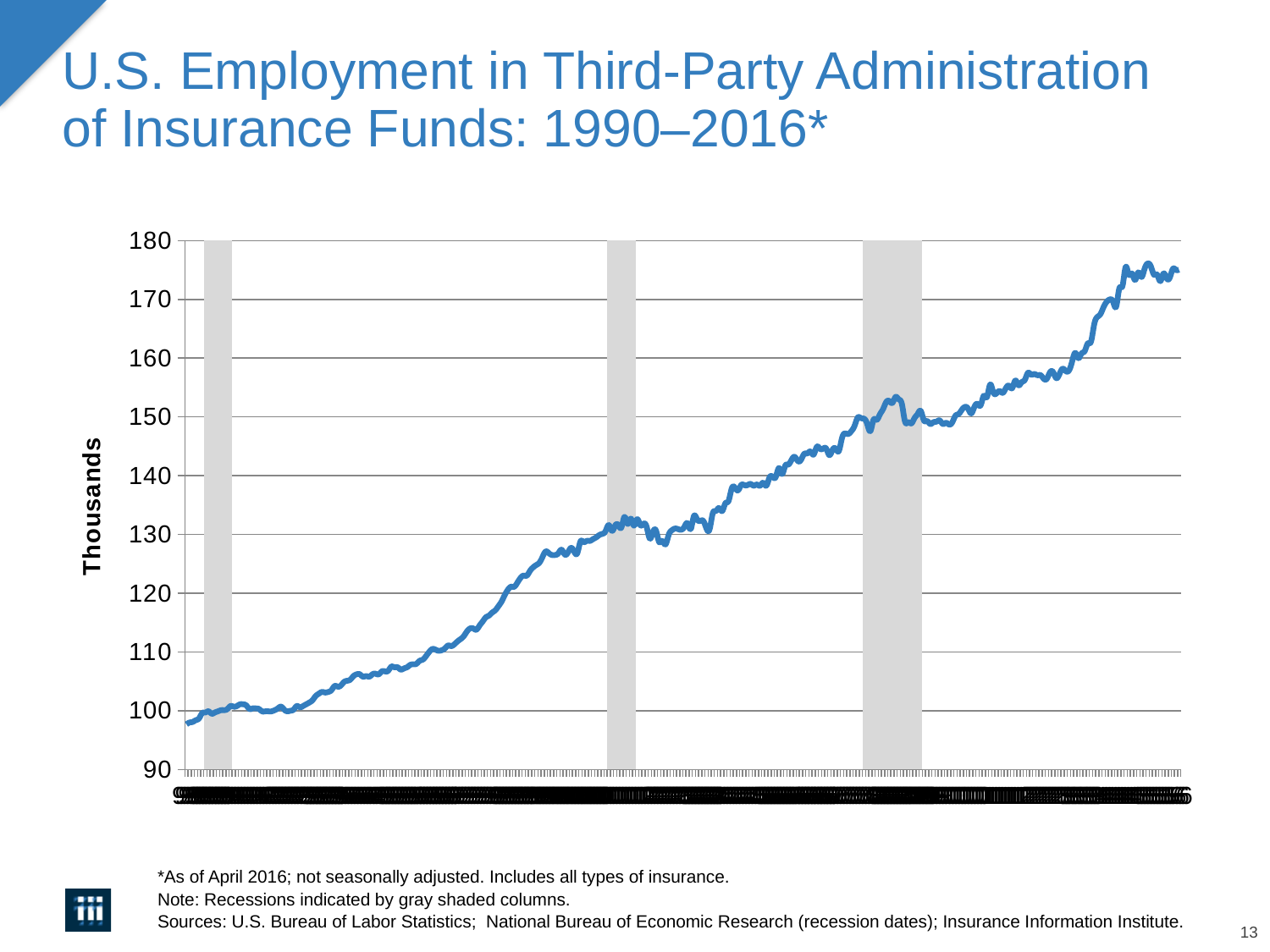
Is the value at the right end of the line (2016) greater or less than 170? greater Is the value at the start of the line (1990) greater or less than 120? less Overall, does employment in third-party administration of insurance funds rise or fall from 1990 to 2016? rise Is the value at the end of the line (2016) larger or smaller than the value at the start (1990)? larger How many gray shaded recession columns are shown on the chart? 3 Is the highest point of the line greater or less than 170? greater What kind of chart is shown on the slide? line chart What is the label on the vertical axis? Thousands What is the lowest value shown on the vertical axis? 90 What is the highest value shown on the vertical axis? 180